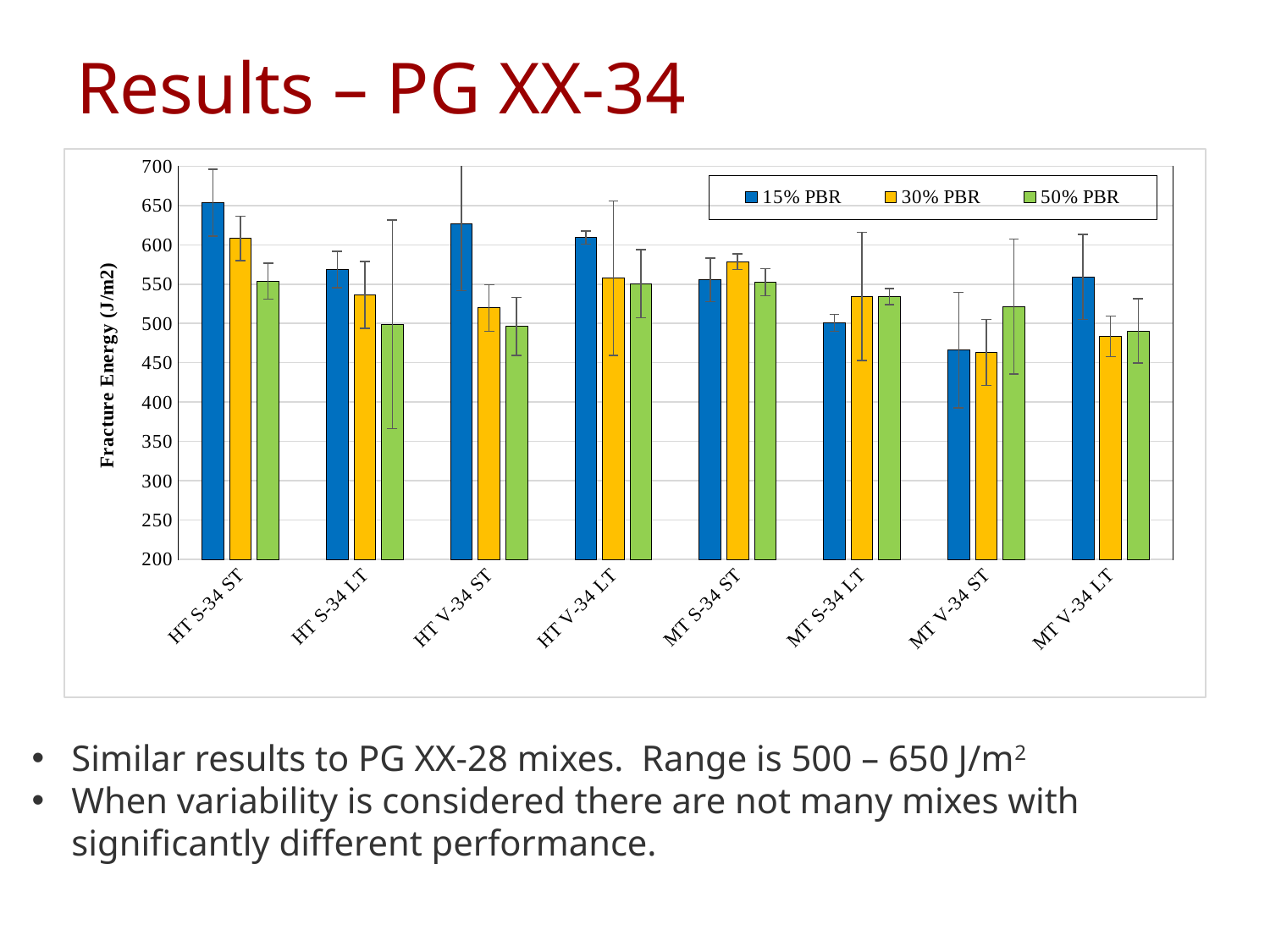
What is the label of the vertical axis of the chart? Fracture Energy (J/m2) How many mix categories are shown along the x axis of the chart? 8 How many series does the chart legend list? 3 Which series are listed in the chart legend? 15% PBR, 30% PBR, 50% PBR What kind of chart is shown on the slide? Bar chart For HT S-34 ST, which is larger: the 15% PBR bar or the 30% PBR bar? 15% PBR Is the 15% PBR value for HT S-34 ST greater or less than 600? greater Is the 15% PBR value for MT V-34 ST greater or less than 500? less Which category has the highest 15% PBR bar? HT S-34 ST For MT V-34 ST, which is larger: the 15% PBR bar or the 50% PBR bar? 50% PBR Is the 15% PBR value for HT V-34 ST greater or less than 600? greater Which category has the lowest 15% PBR bar? MT V-34 ST